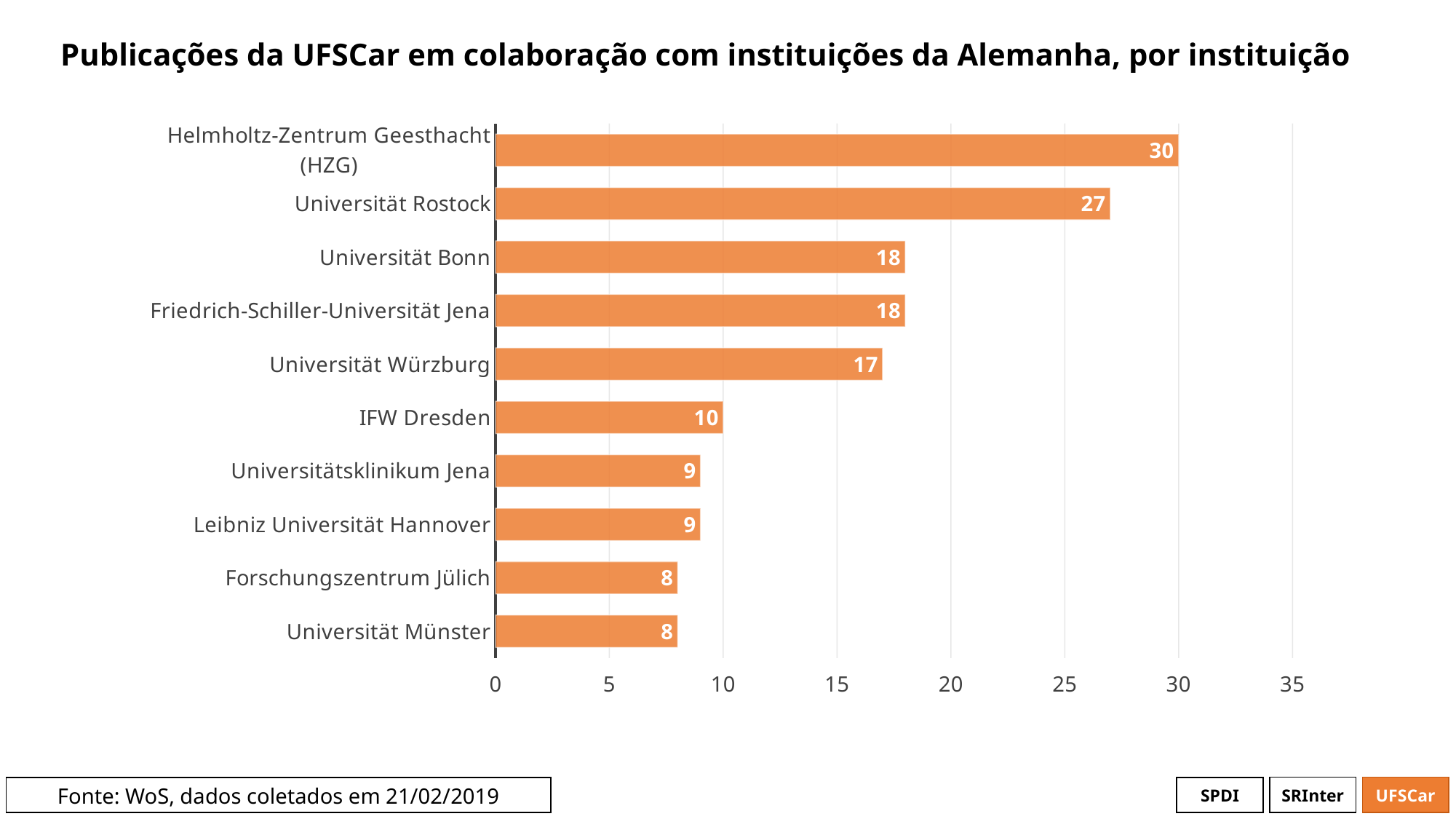
What is the difference between the values for Helmholtz-Zentrum Geesthacht (HZG) and Universität Rostock? 3 Which institution has the highest number of publications in collaboration with UFSCar? Helmholtz-Zentrum Geesthacht (HZG) What is the difference between the values for Universität Bonn and IFW Dresden? 8 What kind of chart is shown on the slide? Bar chart How many institutions are listed in the chart? 10 What is the value shown for IFW Dresden? 10 How many publications does the chart show for Universität Rostock? 27 What is the title of the chart? Publicações da UFSCar em colaboração com instituições da Alemanha, por instituição What is the value shown for Universität Würzburg? 17 What is the highest value shown on the horizontal axis? 35 Which is larger, the value for Universität Würzburg or the value for Universitätsklinikum Jena? Universität Würzburg Is the value for Universität Rostock greater or less than 25? greater